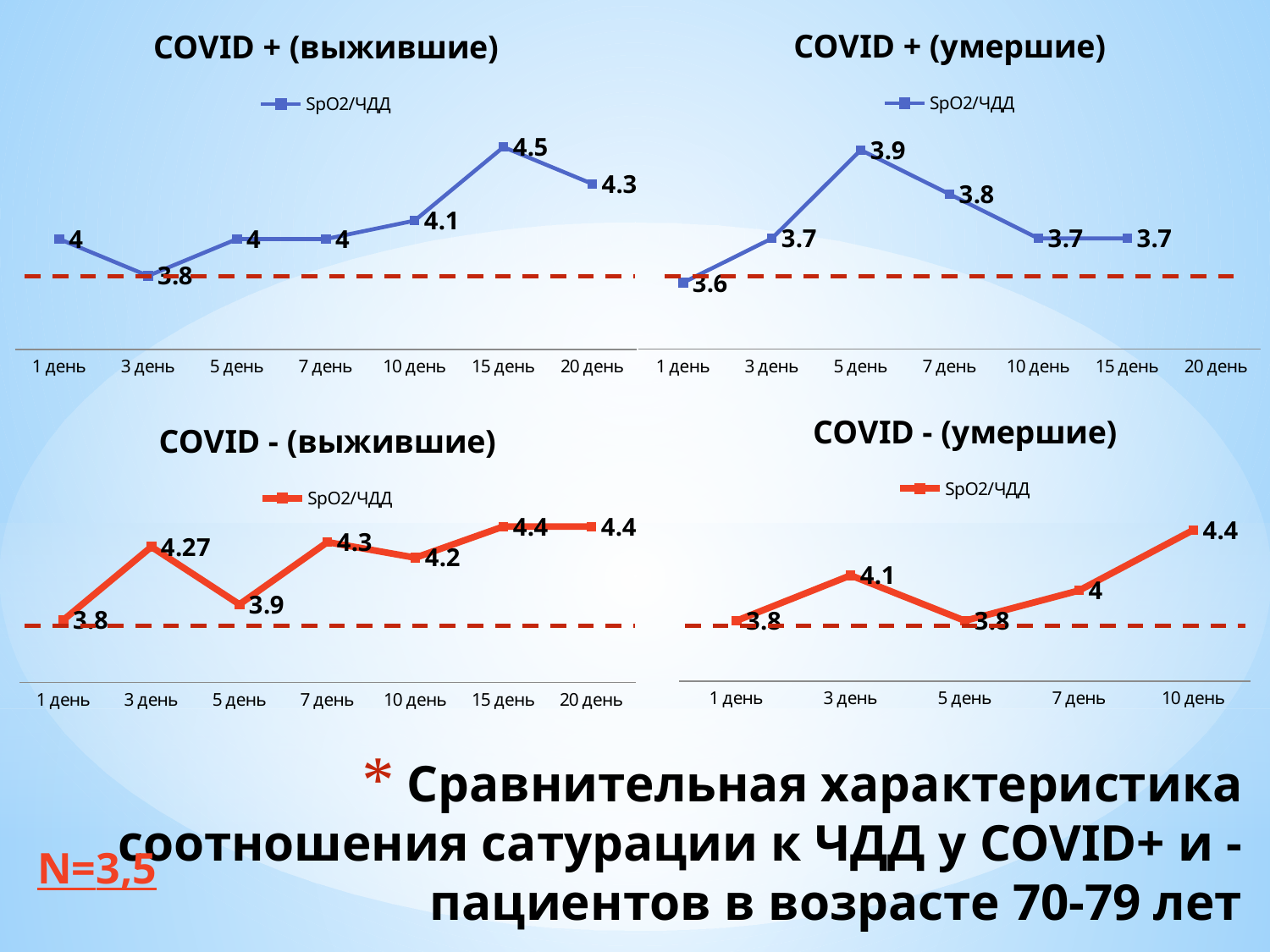
In the "COVID + (выжившие)" chart, what is the difference between the values for 15 день and 3 день? 0.7 In the "COVID + (умершие)" chart, what is the value for 1 день? 3.6 In the "COVID + (выжившие)" chart, what is the value for 15 день? 4.5 In the "COVID - (выжившие)" chart, what is the value for 3 день? 4.27 What series name does the legend show in the "COVID - (выжившие)" chart? SpO2/ЧДД In the "COVID + (выжившие)" chart, which day has the lowest value? 3 день In the "COVID - (умершие)" chart, what is the value for 10 день? 4.4 In the "COVID + (умершие)" chart, which day has the highest value? 5 день In the "COVID - (умершие)" chart, which is larger: the value for 3 день or the value for 7 день? 3 день How many data points are plotted in the "COVID - (умершие)" chart? 5 How many data points are plotted in the "COVID - (выжившие)" chart? 7 What type of chart is the "COVID + (умершие)" chart? Line chart